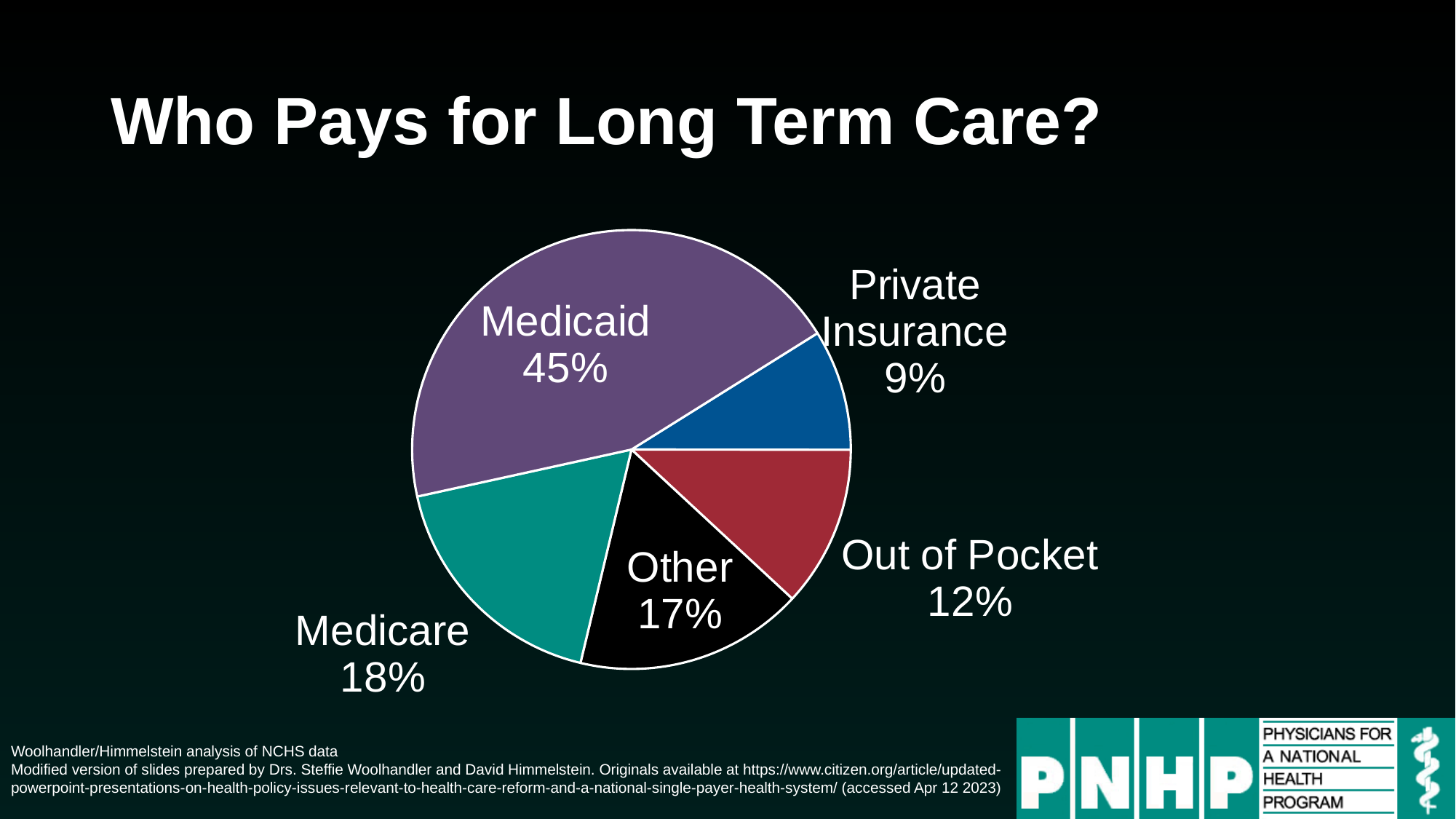
How many slices does the pie chart have? 5 Which payer has the largest slice of the pie? Medicaid What share of long term care is paid Out of Pocket? 12% What kind of chart is shown on the slide? pie chart What share of long term care is paid by Private Insurance? 9% What share of long term care is paid by Medicare? 18% Which is larger, the Out of Pocket share or the Private Insurance share? Out of Pocket What is the difference in percentage points between Medicaid and Medicare? 27 What is the title of the chart? Who Pays for Long Term Care? What share of long term care is paid by Medicaid? 45% What colour is the Medicaid slice? purple Which payer has the smallest slice of the pie? Private Insurance